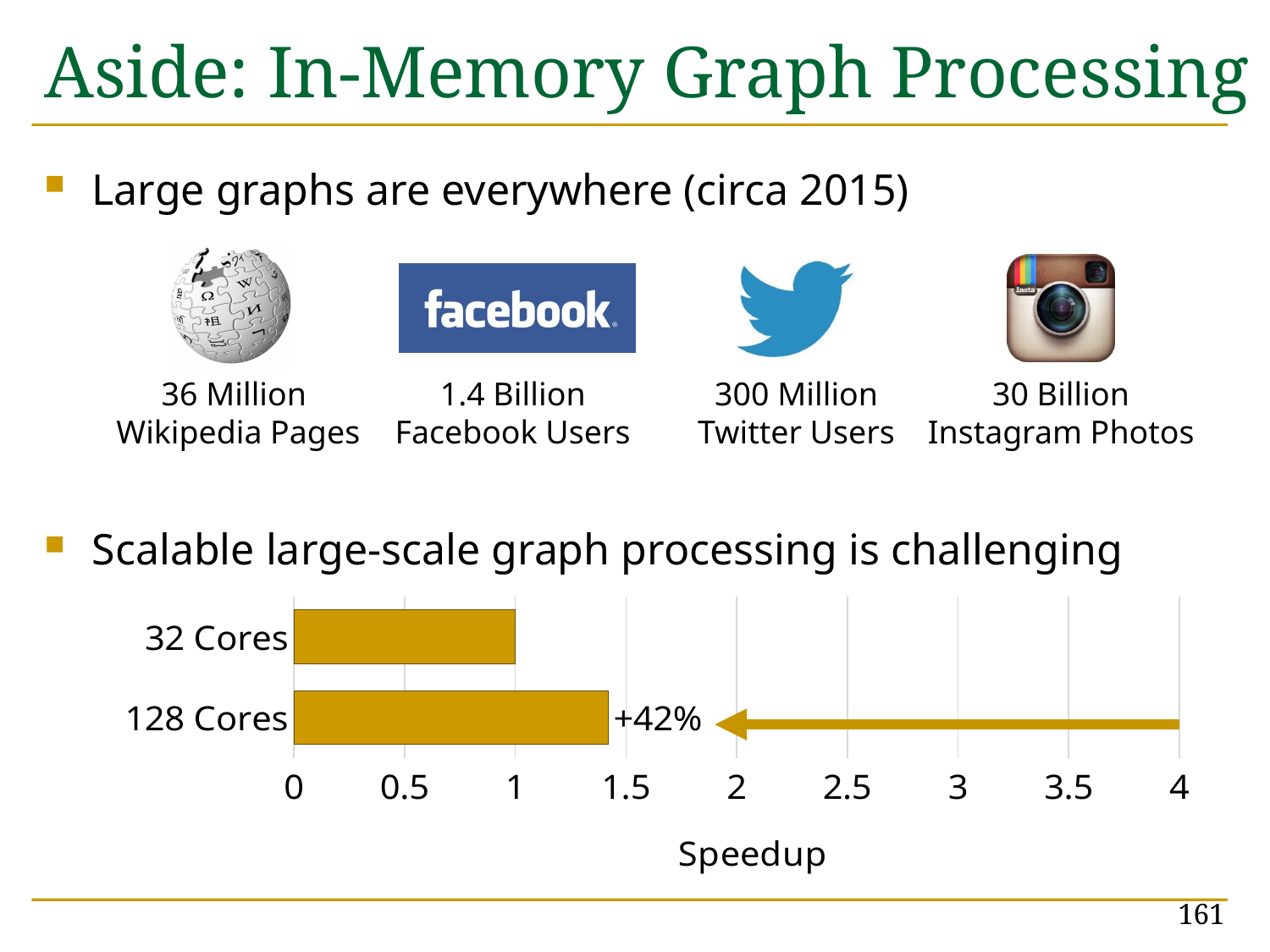
Is the speedup for 128 Cores greater or less than 1.5? less Which category has the lowest speedup? 32 Cores Which category has the highest speedup? 128 Cores Which has a larger speedup, 32 Cores or 128 Cores? 128 Cores Is the speedup for 128 Cores greater or less than 1? greater What kind of chart is shown at the bottom of the slide? bar chart How many categories does the Speedup bar chart show? 2 What is the maximum value shown on the x axis of the bar chart? 4 Is the speedup for 128 Cores greater or less than 2? less What is the title of the x axis of the bar chart? Speedup What percentage annotation is shown next to the 128 Cores bar? +42% What is the speedup value for 32 Cores? 1